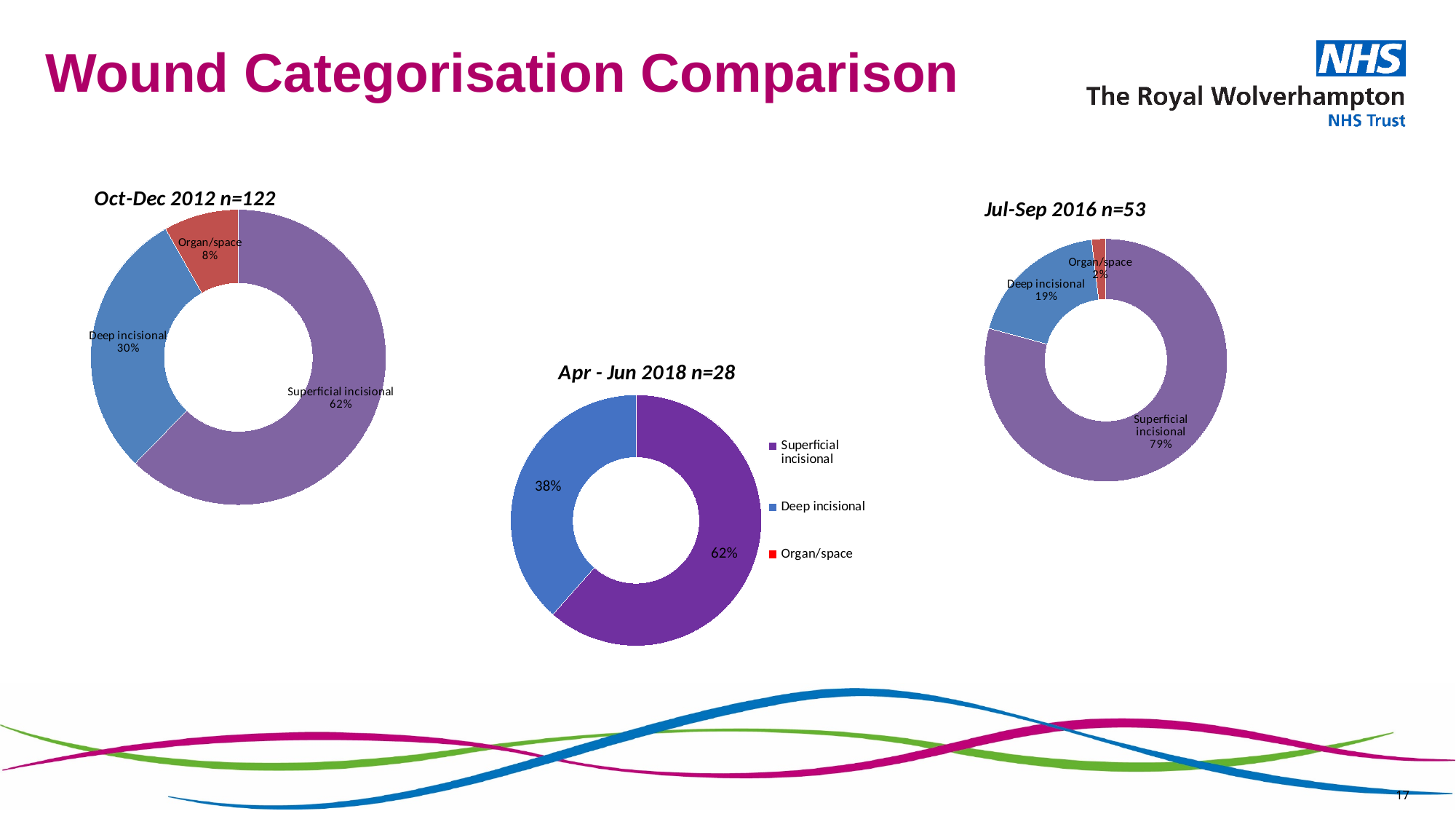
In the Jul-Sep 2016 n=53 chart, what share is Superficial incisional? 79% In the Oct-Dec 2012 n=122 chart, what share is Organ/space? 8% In the Apr - Jun 2018 n=28 chart, what share is Deep incisional? 38% How many charts are shown on the slide? 3 How many series does the legend of the Apr - Jun 2018 n=28 chart list? 3 In the Oct-Dec 2012 n=122 chart, which category has the largest share? Superficial incisional In the Oct-Dec 2012 n=122 chart, what share is Deep incisional? 30% In the Jul-Sep 2016 n=53 chart, what is the difference between the Superficial incisional and Deep incisional shares? 60% What kind of chart is the Apr - Jun 2018 n=28 chart? Doughnut chart In the Jul-Sep 2016 n=53 chart, what share is Organ/space? 2% Is the Deep incisional share larger in the Oct-Dec 2012 n=122 chart or the Jul-Sep 2016 n=53 chart? Oct-Dec 2012 n=122 In the Jul-Sep 2016 n=53 chart, which category has the smallest share? Organ/space